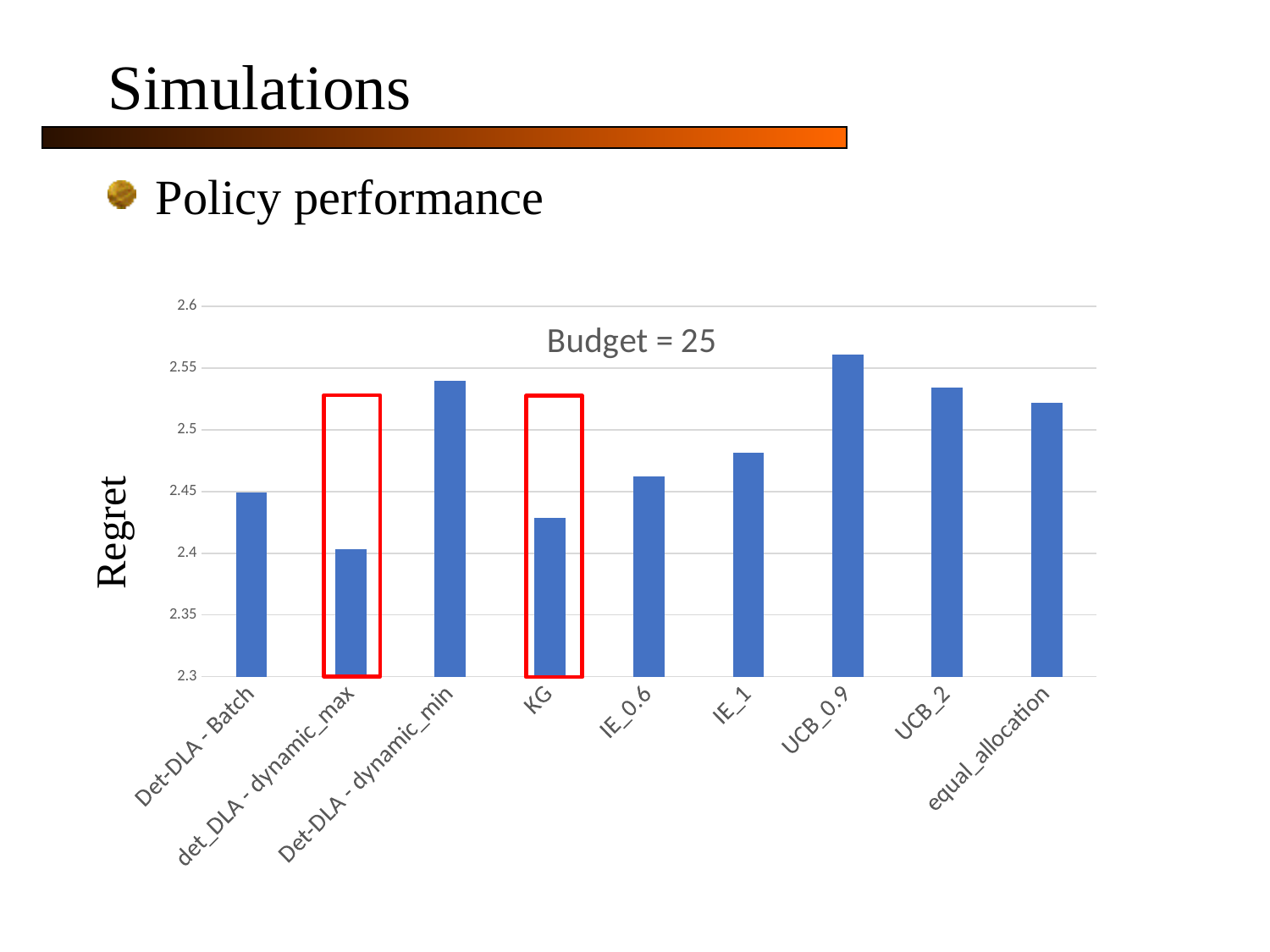
Which has the higher regret, Det-DLA - dynamic_min or KG? Det-DLA - dynamic_min Is the regret for det_DLA - dynamic_max greater or less than 2.45? less Which has the lower regret, IE_0.6 or equal_allocation? IE_0.6 Is the regret for IE_1 greater or less than 2.5? less Is the regret for UCB_0.9 greater or less than 2.55? greater How many policies (categories) are plotted in the chart? 9 What is the label on the vertical axis of the chart? Regret Which policy has the highest regret in the chart? UCB_0.9 What kind of chart is shown on the slide? bar chart Which policy has the lowest regret in the chart? det_DLA - dynamic_max What is the title of the chart? Budget = 25